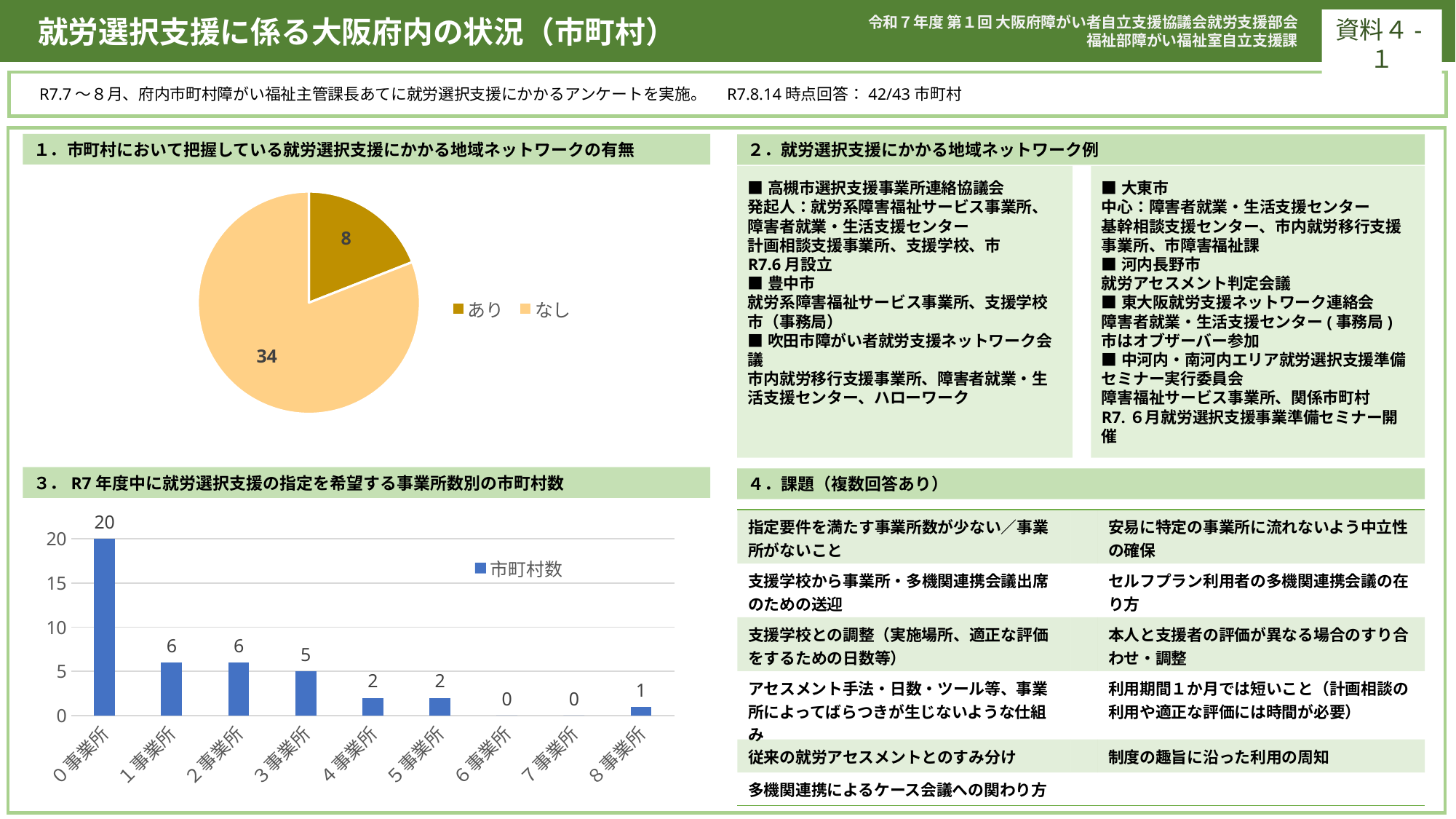
In the bar chart in section 3, what is the difference between the values for 0事業所 and 1事業所? 14 In the bar chart in section 3, what is the value for 3事業所? 5 In the pie chart in section 1 (地域ネットワークの有無), what is the value for あり? 8 In the pie chart in section 1, how many slices are there? 2 In the bar chart in section 3, what series name does the legend show? 市町村数 In the bar chart in section 3, how many categories are shown on the x axis? 9 In the pie chart in section 1, what is the value for なし? 34 In the bar chart in section 3 (事業所数別の市町村数), what is the value for 0事業所? 20 In the bar chart in section 3, which category has the highest value? 0事業所 What kind of chart is shown in section 3? bar chart In the pie chart in section 1, which slice is larger, あり or なし? なし In the pie chart in section 1, what is the total of the two slices? 42